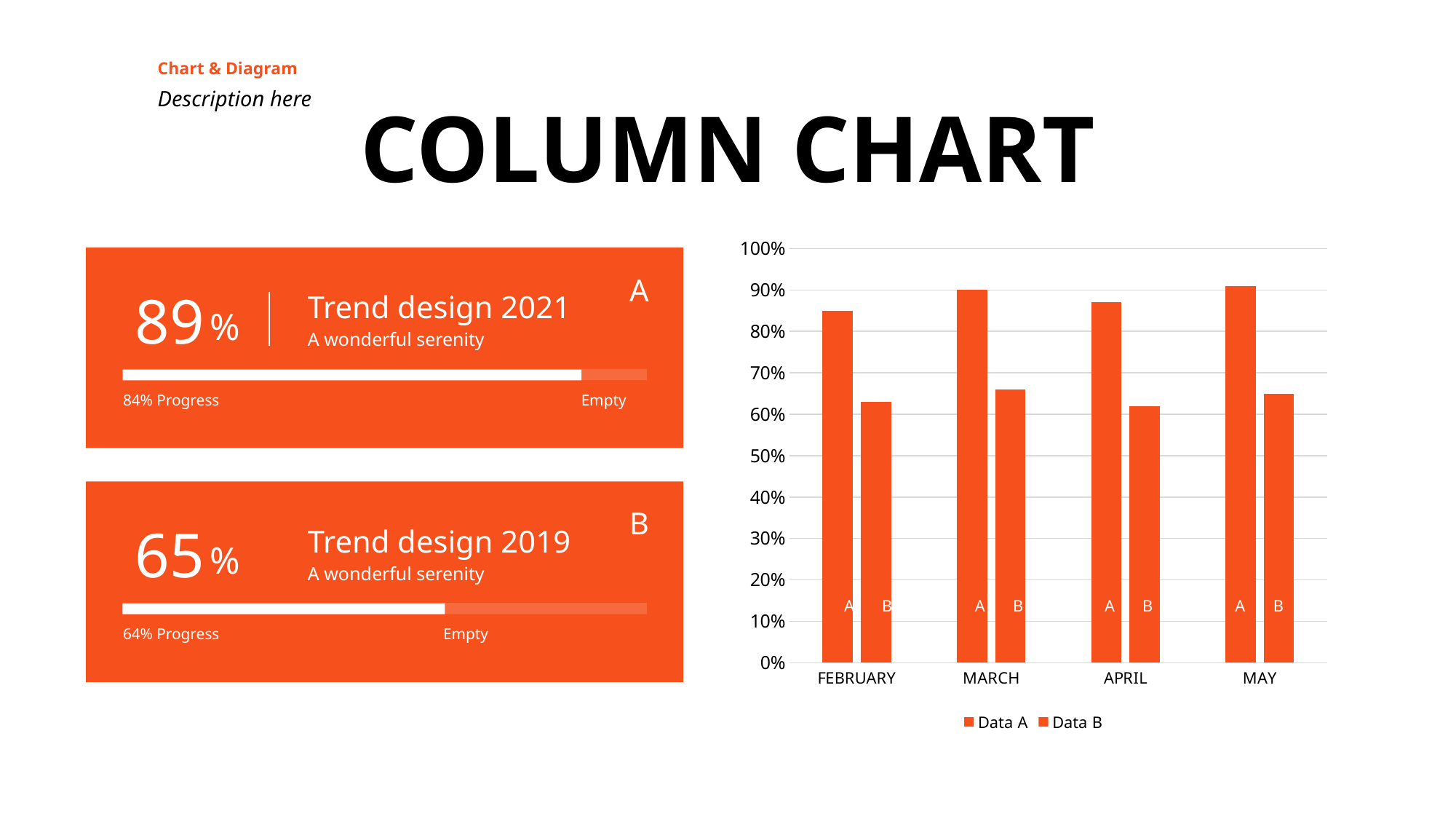
Is the value for Data B in May greater or less than 70%? less Is the value for Data A in February greater or less than 80%? greater What kind of chart is shown on the right of the slide? bar chart Is the value for Data B in March greater or less than 70%? less How many series does the legend of the bar chart list? 2 What are the two series named in the legend of the bar chart? Data A and Data B How many categories are shown on the x axis of the bar chart? 4 In February, which is larger, Data A or Data B? Data A Which months are shown on the x axis of the bar chart? February, March, April, May In May, which is larger, Data A or Data B? Data A